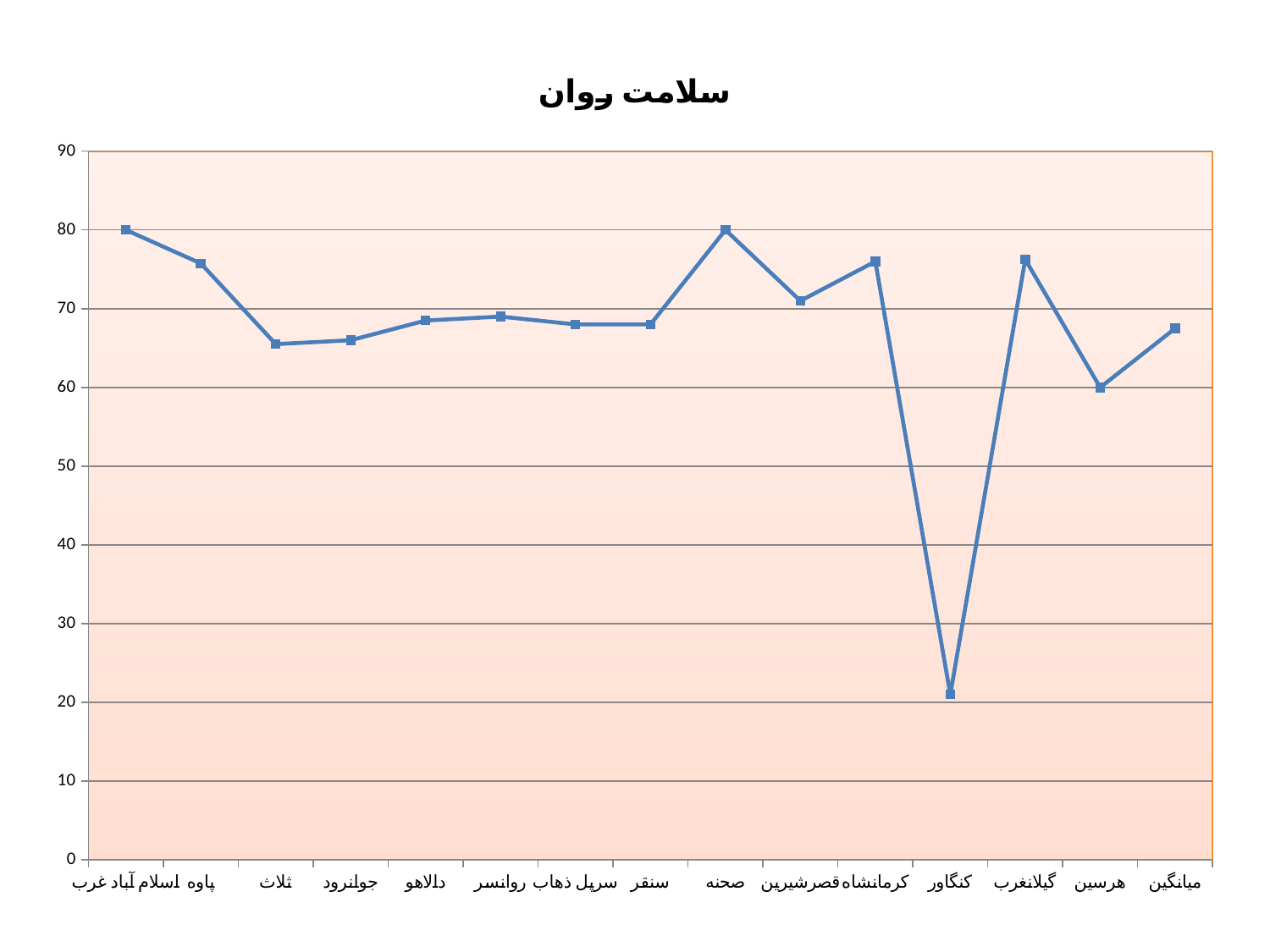
Is the value for کنگاور greater or less than 30? less Which has the larger value, کنگاور or هرسین? هرسین Which category has the lowest value? کنگاور Which has the larger value, پاوه or ثلاث? پاوه What kind of chart is shown on the slide? line chart How many categories are plotted along the x axis? 15 Is the value for هرسین greater or less than 70? less Is the value for گیلانغرب greater or less than 70? greater Does the line rise or fall from کرمانشاه to کنگاور? fall What is the title of the chart? سلامت روان